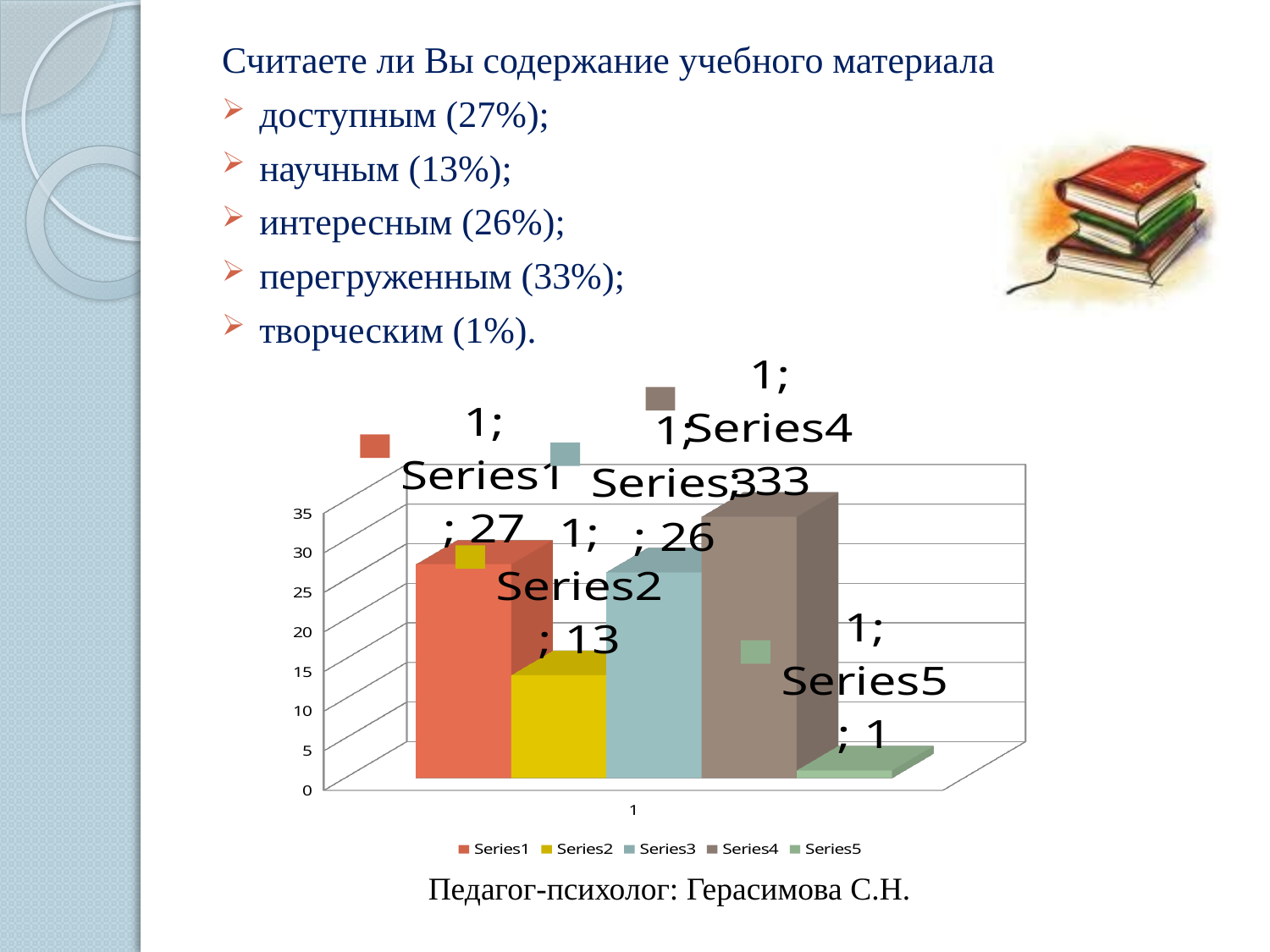
What is the highest value shown on the vertical axis of the chart? 35 Which is larger, the value for Series1 or the value for Series3? Series1 What kind of chart is shown on the slide? bar chart Which series has the highest value in the chart? Series4 How many series does the legend list? 5 What value is shown for Series2 in the chart? 13 What value is shown for Series1 in the chart? 27 What value is shown for Series5 in the chart? 1 Is the value for Series3 greater or less than 20? greater What is the difference between the values of Series4 and Series2? 20 What value is shown for Series4 in the chart? 33 Which series has the lowest value in the chart? Series5